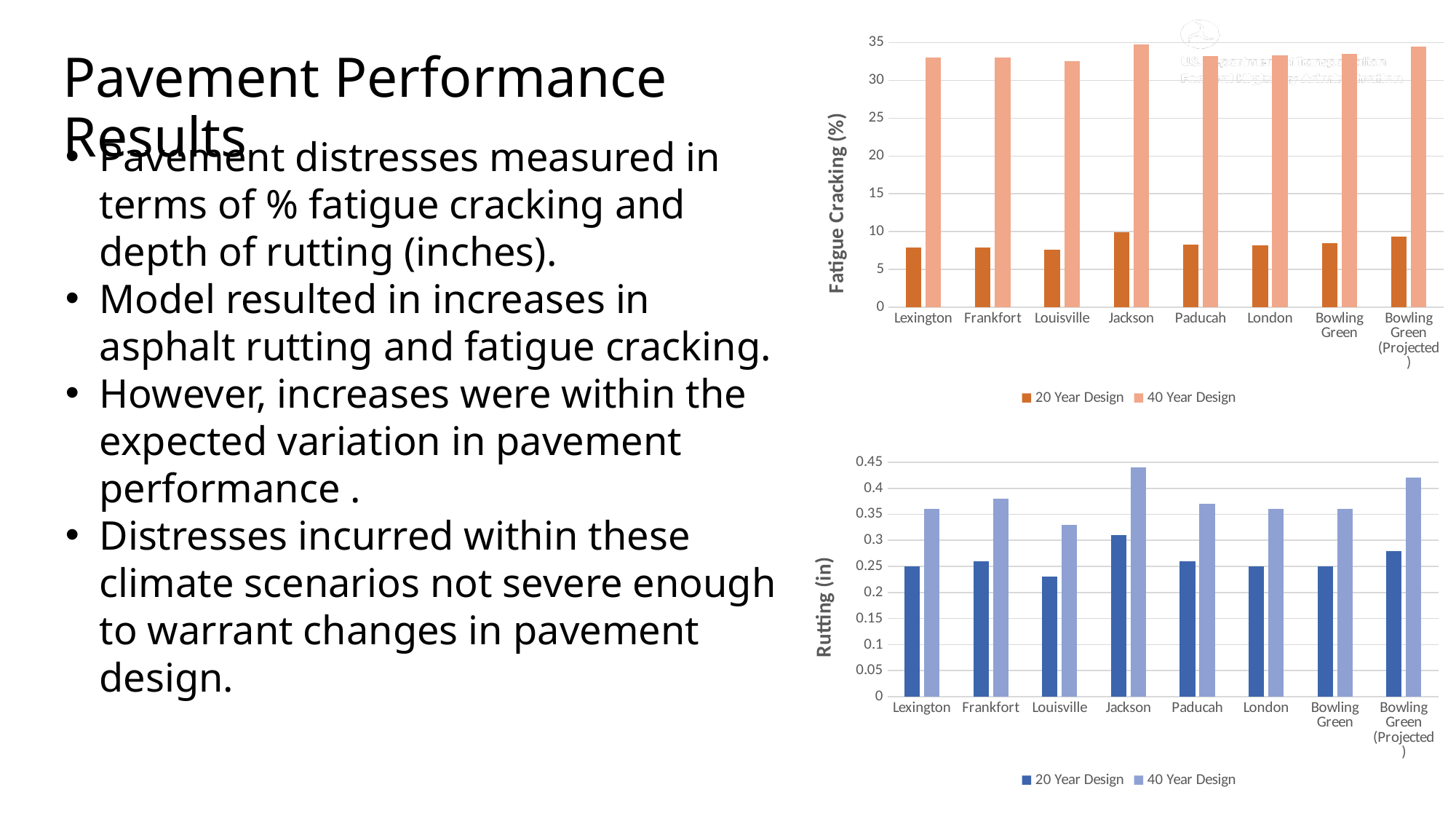
In the top chart (Fatigue Cracking), which location has the highest 20 Year Design value? Jackson In the top chart (Fatigue Cracking), how many locations are shown on the x axis? 8 In the top chart (Fatigue Cracking), is the 20 Year Design value for Jackson greater or less than 15? less In the top chart (Fatigue Cracking), how many series does the legend list? 2 In the bottom chart, what is the y-axis title? Rutting (in) What kind of chart is the top chart (Fatigue Cracking)? bar chart In the top chart (Fatigue Cracking), is the 40 Year Design value for Lexington greater or less than 30? greater In the top chart (Fatigue Cracking), which is larger for the 20 Year Design series: Jackson or Louisville? Jackson In the bottom chart (Rutting), which location has the highest 40 Year Design value? Jackson In the bottom chart (Rutting), is the 40 Year Design value for Jackson greater or less than 0.4? greater In the bottom chart (Rutting), which location has the lowest 40 Year Design value? Louisville In the top chart (Fatigue Cracking), what are the two legend entries? 20 Year Design and 40 Year Design